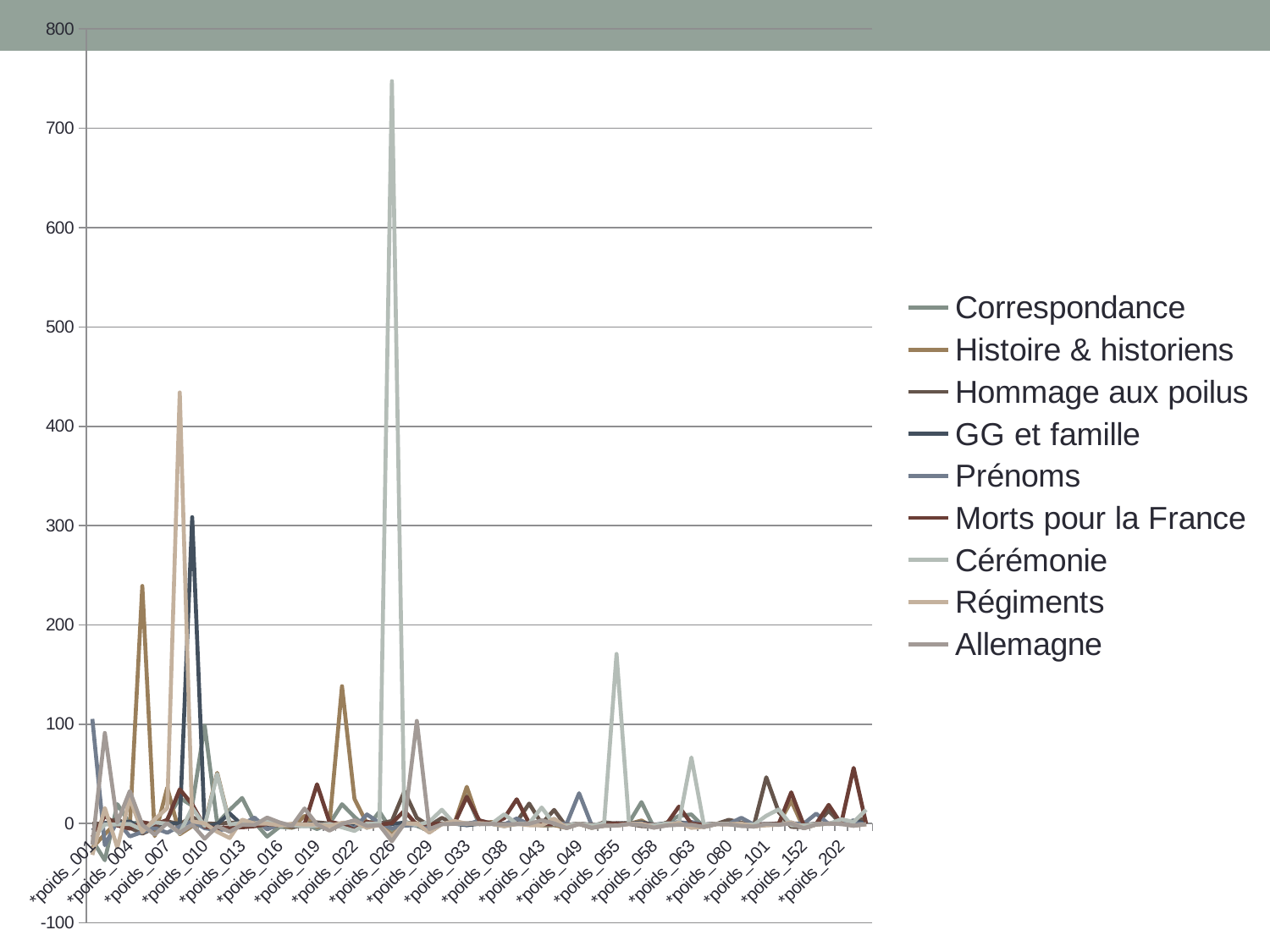
Is the highest peak of the GG et famille series greater or less than 400? less Which series reaches the highest peak on the chart? Cérémonie Is the Cérémonie peak near *poids_055 greater or less than 200? less What is the last entry listed in the legend? Allemagne Which has a higher peak, the Régiments series or the Histoire & historiens series? Régiments What kind of chart is shown on the slide? line chart What is the first entry listed in the legend? Correspondance Which has a higher peak, the Cérémonie series or the Régiments series? Cérémonie Is the highest peak of the Cérémonie series greater or less than 700? greater How many series does the legend list? 9